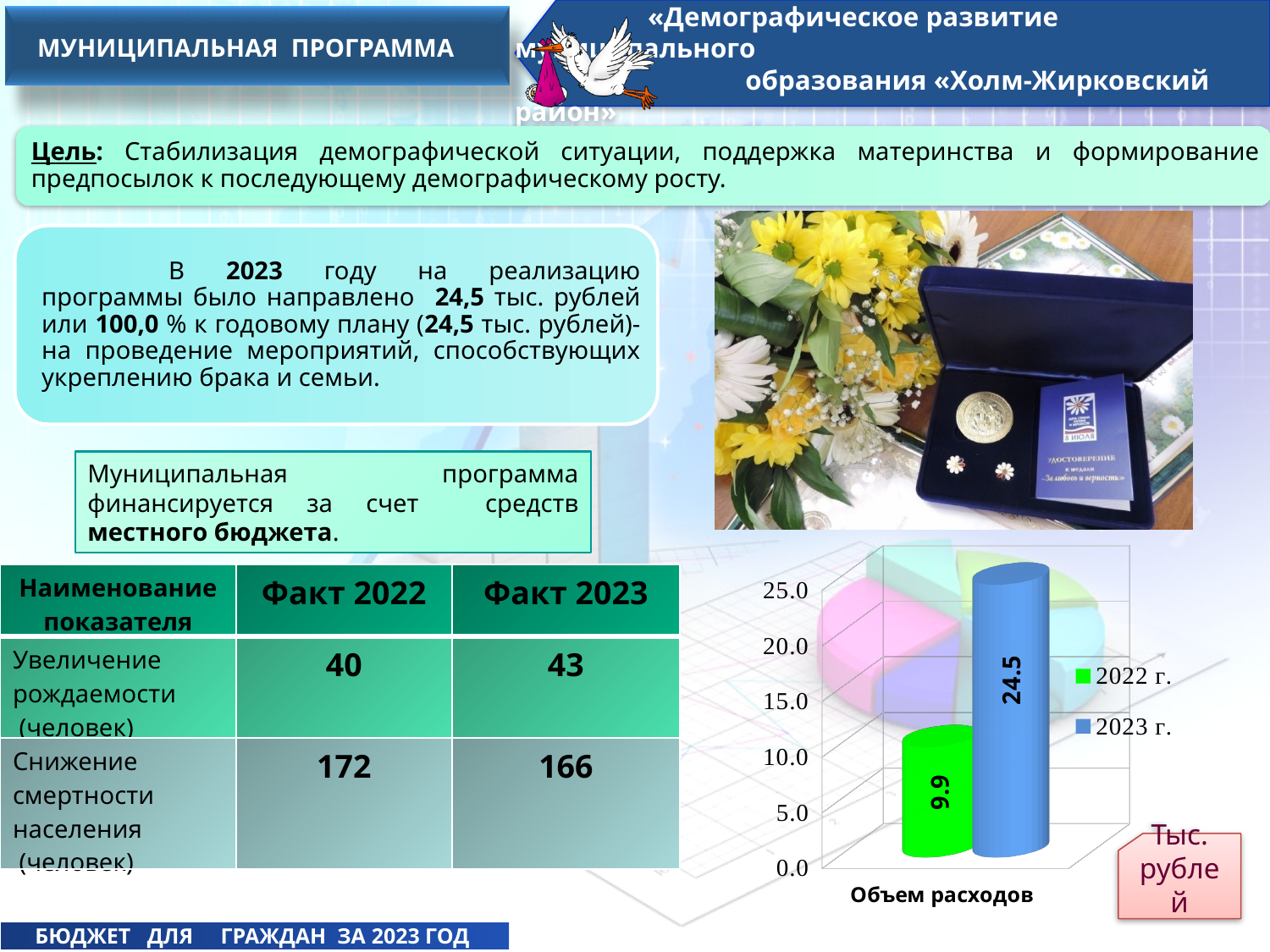
What is the value for 2022 г. in the chart? 9.9 Which series has the higher value in the chart, 2022 г. or 2023 г.? 2023 г. What is the difference between the 2023 г. and 2022 г. values in the chart? 14.6 Is the value for 2023 г. greater or less than 20.0? greater How many series does the chart legend list? 2 What colour is the bar for 2023 г. in the chart? blue What is the value for 2023 г. in the chart? 24.5 What is the category label shown under the bars in the chart? Объем расходов What kind of chart is shown on the slide? bar chart Which series has the lowest value in the chart? 2022 г. Is the value for 2022 г. greater or less than 10.0? less What is the highest value shown on the chart's vertical axis? 25.0